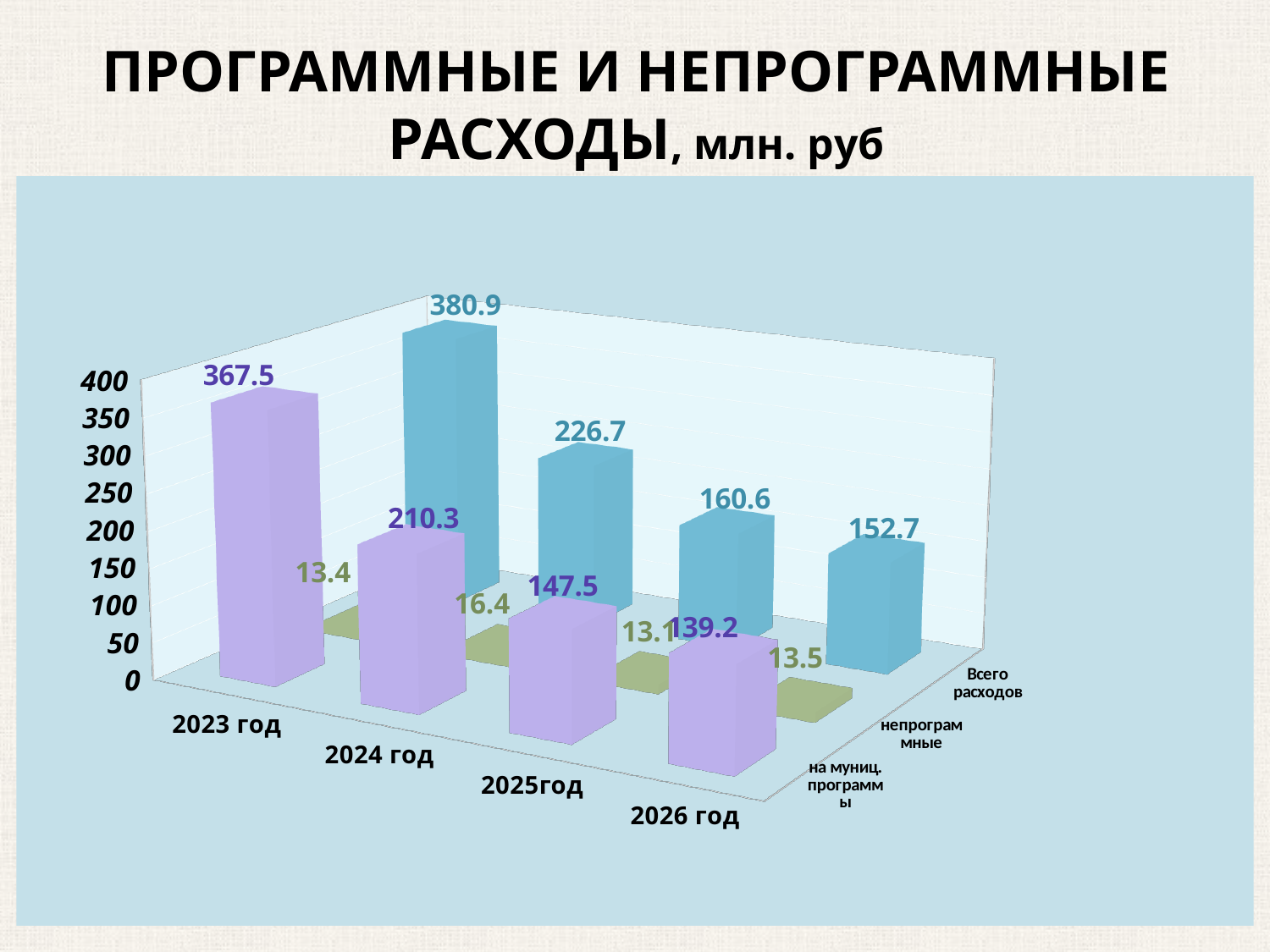
Which is larger: "непрограммные" in 2024 год or "непрограммные" in 2025год? 2024 год Is the value for "на муниц. программы" in 2024 год greater or less than 200? greater Which year has the highest value for "Всего расходов"? 2023 год Which year has the lowest value for "на муниц. программы"? 2026 год What is the value for "непрограммные" in 2024 год? 16.4 How many data series does the chart show? 3 What is the difference between "Всего расходов" in 2023 год and in 2026 год? 228.2 How many years are shown on the x axis? 4 What kind of chart is shown on the slide? bar chart Do the values for "Всего расходов" rise or fall from 2023 год to 2026 год? fall What is the value for "на муниц. программы" in 2023 год? 367.5 What is the value for "Всего расходов" in 2025год? 160.6